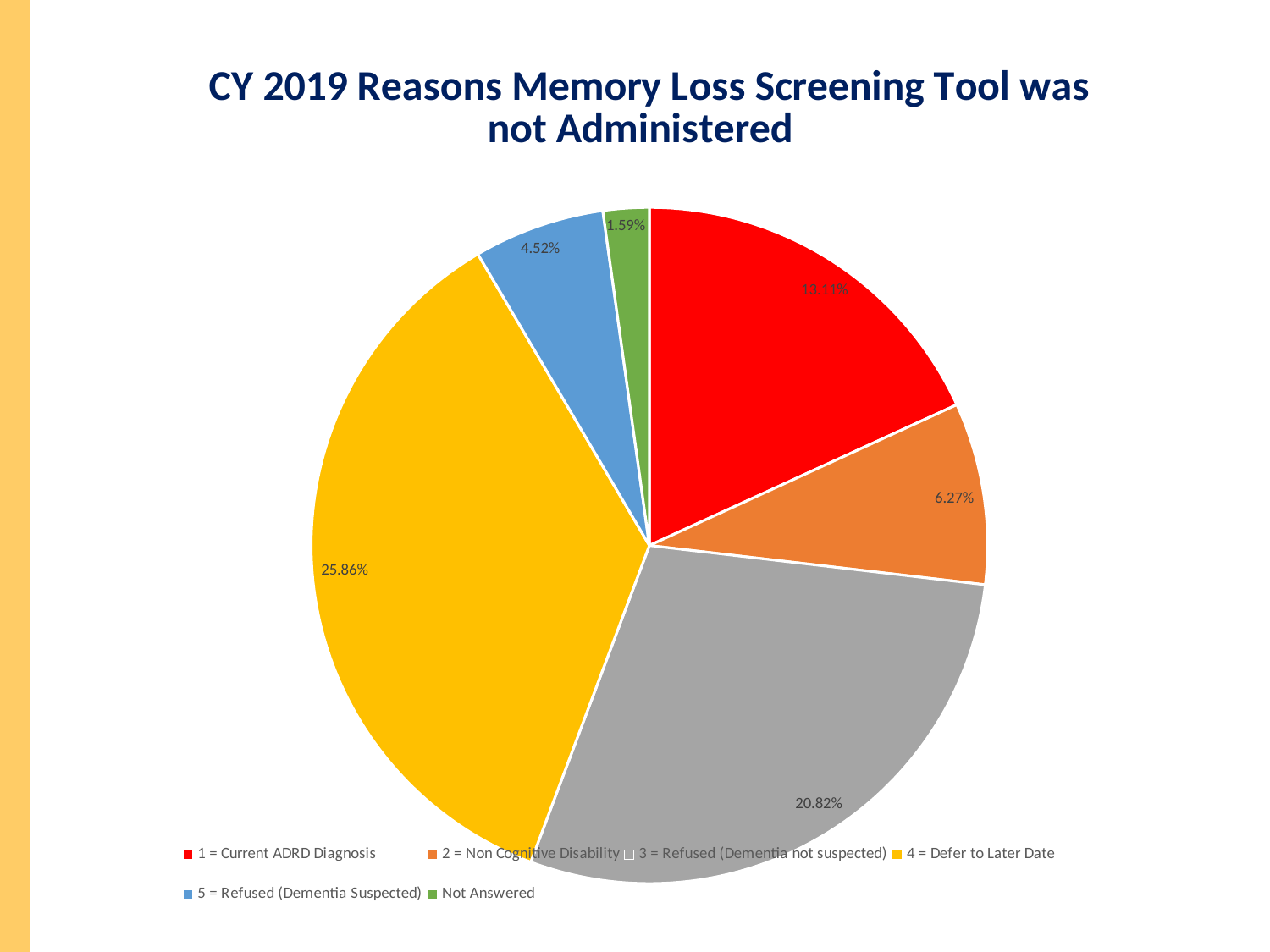
What is the difference between the values for 4 = Defer to Later Date and 3 = Refused (Dementia not suspected)? 5.04% What is the value shown for 5 = Refused (Dementia Suspected)? 4.52% What is the value shown for Not Answered? 1.59% What kind of chart is shown on the slide? Pie chart What is the value shown for 4 = Defer to Later Date? 25.86% How many categories are shown in the pie chart? 6 Which is larger, the value for 1 = Current ADRD Diagnosis or the value for 2 = Non Cognitive Disability? 1 = Current ADRD Diagnosis Which category has the largest slice of the pie? 4 = Defer to Later Date Which category has the smallest slice of the pie? Not Answered What is the value shown for 1 = Current ADRD Diagnosis? 13.11% What colour is the slice for 2 = Non Cognitive Disability? Orange What is the value shown for 3 = Refused (Dementia not suspected)? 20.82%